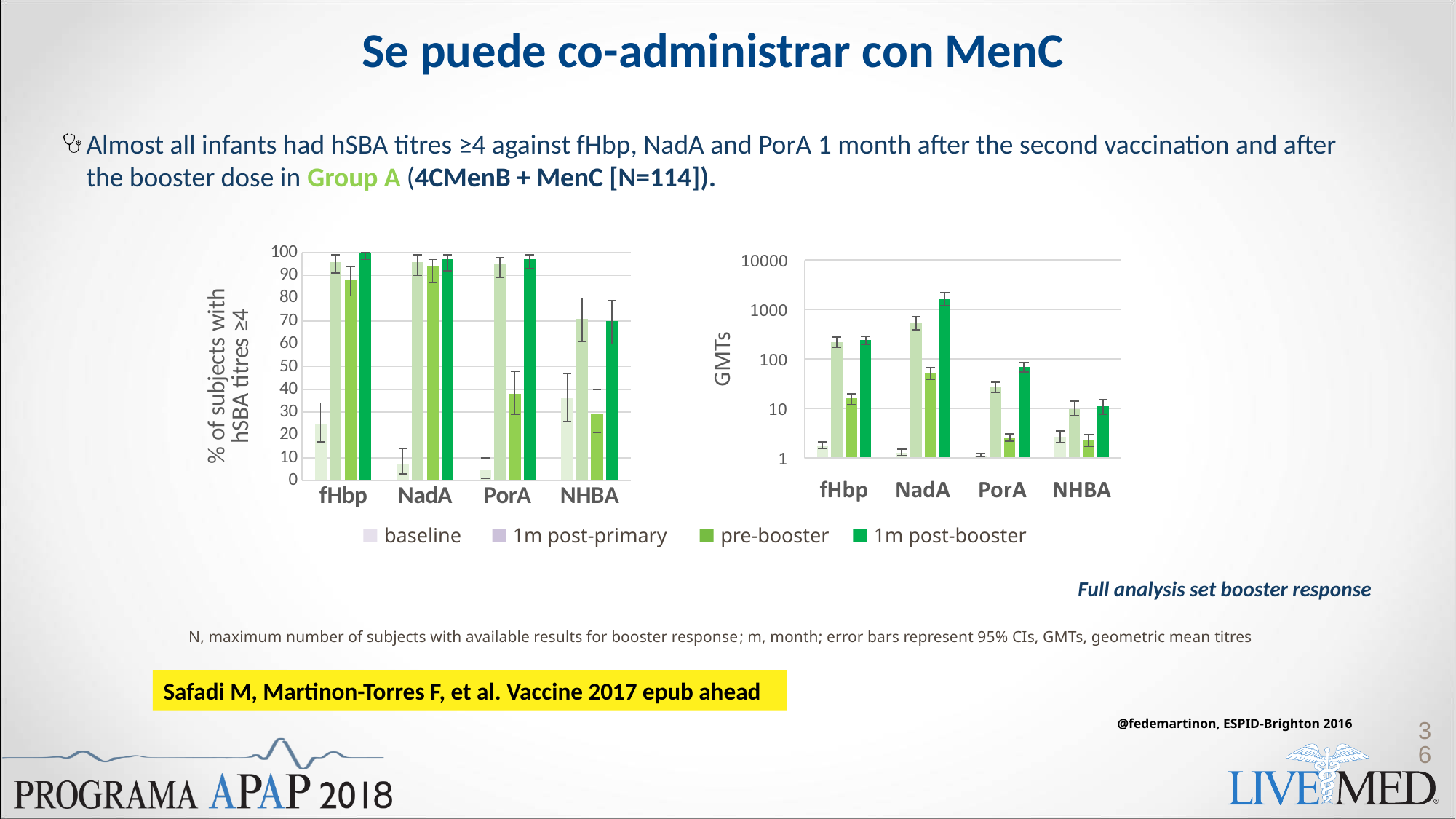
How many series does the shared legend list for the charts? 4 In the GMTs chart, which category has the highest 1m post-booster value? NadA In the GMTs chart, is the 1m post-booster value for PorA greater or less than 100? less In the left chart (% of subjects with hSBA titres ≥4), is the pre-booster value for PorA greater or less than 50? less In the left chart (% of subjects with hSBA titres ≥4), which category has the lowest 1m post-booster value? NHBA In the left chart (% of subjects with hSBA titres ≥4), which is larger: the 1m post-primary value for NHBA or the pre-booster value for PorA? 1m post-primary value for NHBA How many antigen categories are shown on the x axis of the GMTs chart? 4 In the left chart (% of subjects with hSBA titres ≥4), is the 1m post-primary value for NHBA greater or less than 50? greater What kind of chart is the left chart showing % of subjects with hSBA titres ≥4? bar chart What is the y-axis label of the right chart? GMTs